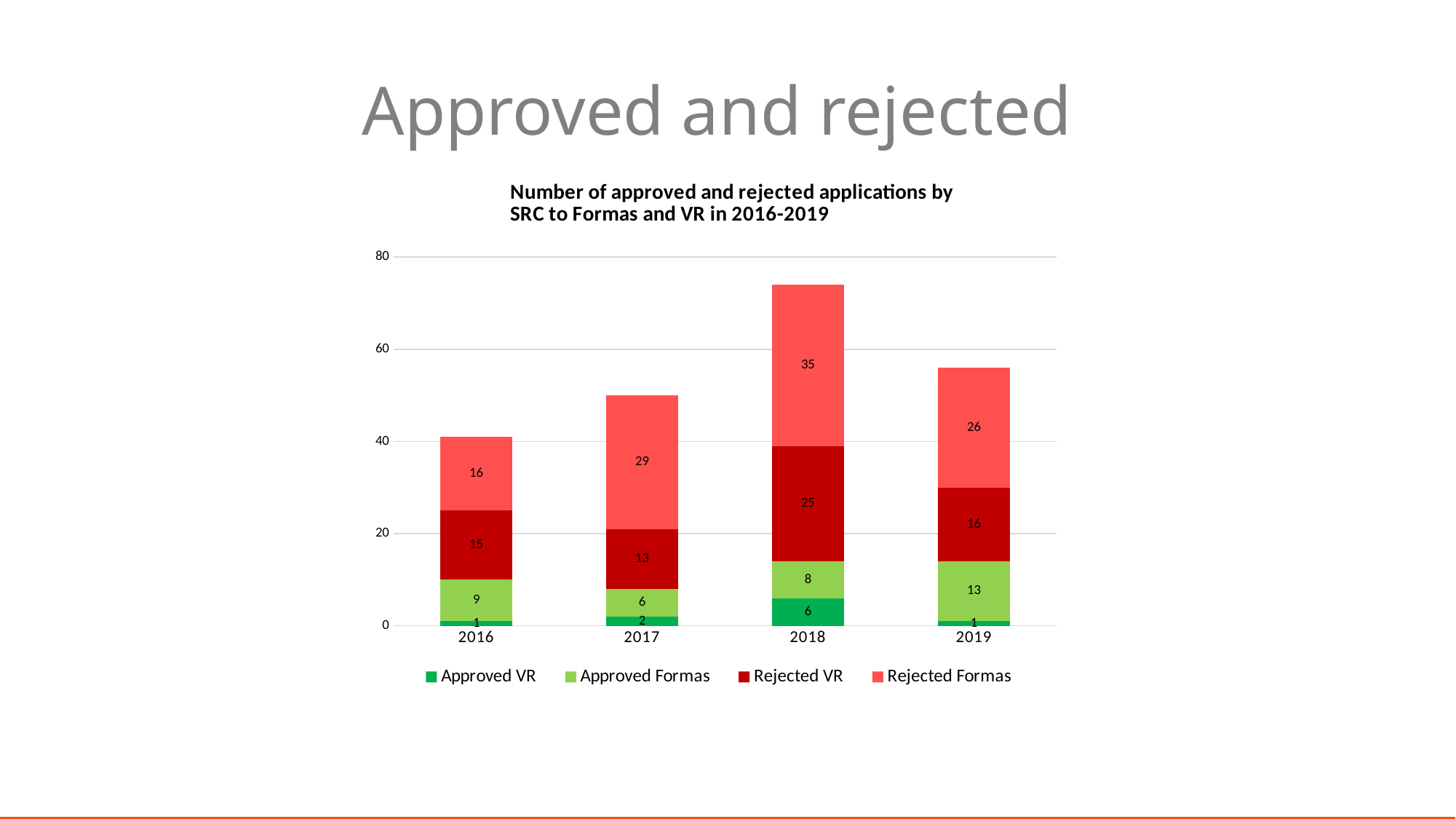
What is the value for Rejected VR in 2017? 13 What is the difference between Rejected Formas in 2018 and Rejected Formas in 2016? 19 What is the total of the stacked bar for 2018? 74 In which year is the Rejected VR value highest? 2018 In which year is the Approved Formas value lowest? 2017 What type of chart is shown on the slide? Stacked bar chart Which is larger: Approved VR in 2018 or Approved VR in 2017? Approved VR in 2018 What is the value for Rejected Formas in 2018? 35 What is the value for Approved Formas in 2019? 13 What is the title of the chart? Number of approved and rejected applications by SRC to Formas and VR in 2016-2019 How many years are shown on the x axis? 4 How many series does the legend list? 4